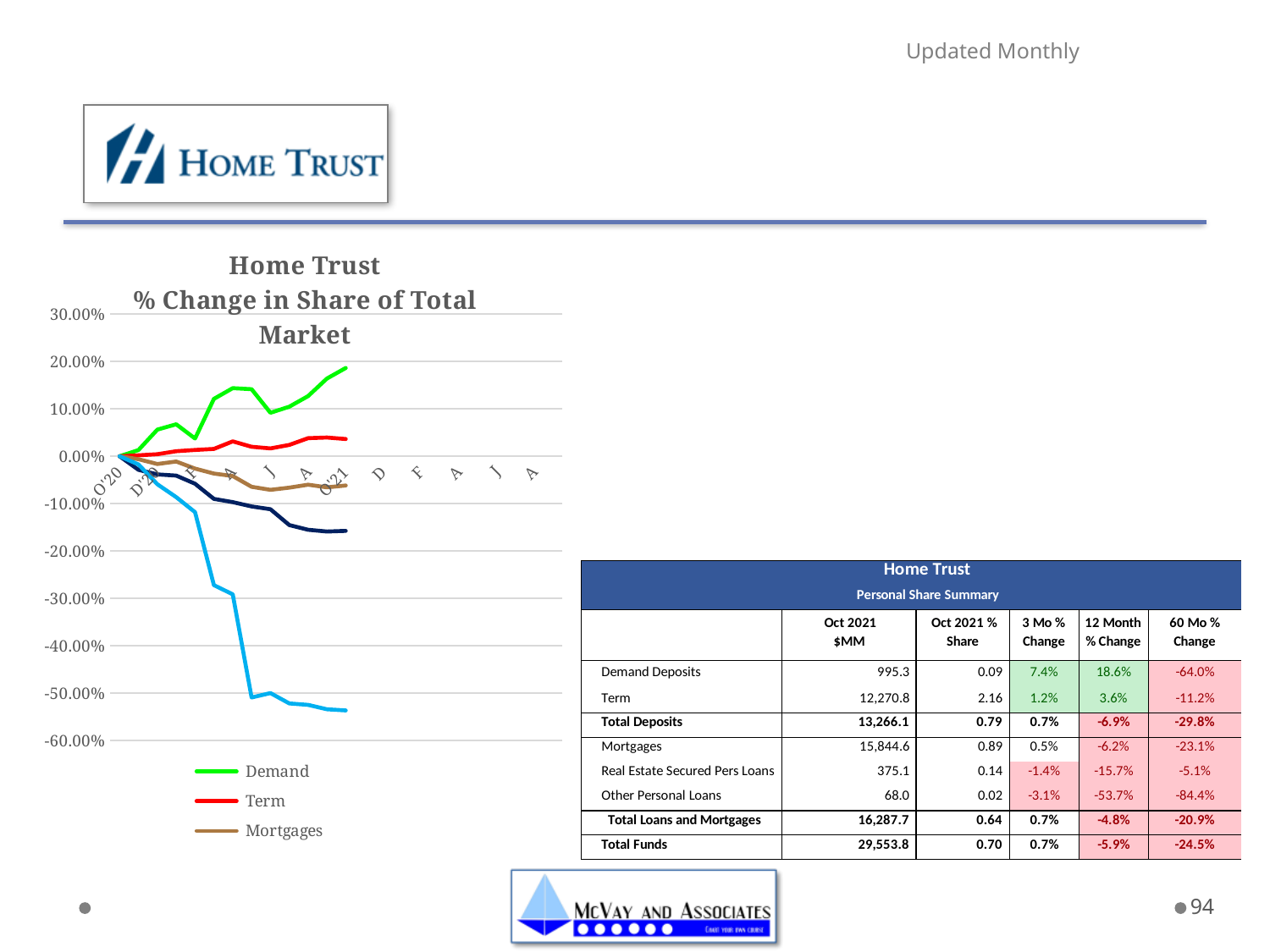
Does the Mortgages line generally rise or fall from O'20 to O'21? fall Does the Demand line generally rise or fall from O'20 to O'21? rise Is the value for Demand at O'21 greater or less than 10.00%? greater Is the value for Term at O'21 greater or less than 0.00%? greater Is the value for Mortgages at O'21 greater or less than 0.00%? less Which of the legend series has the highest value at O'21? Demand What kind of chart is shown on the slide? line chart How many series does the chart legend list? 3 What is the title of the chart? Home Trust % Change in Share of Total Market Which of the legend series, Demand or Mortgages, has the higher value at O'21? Demand What colour is the Demand line in the chart? green